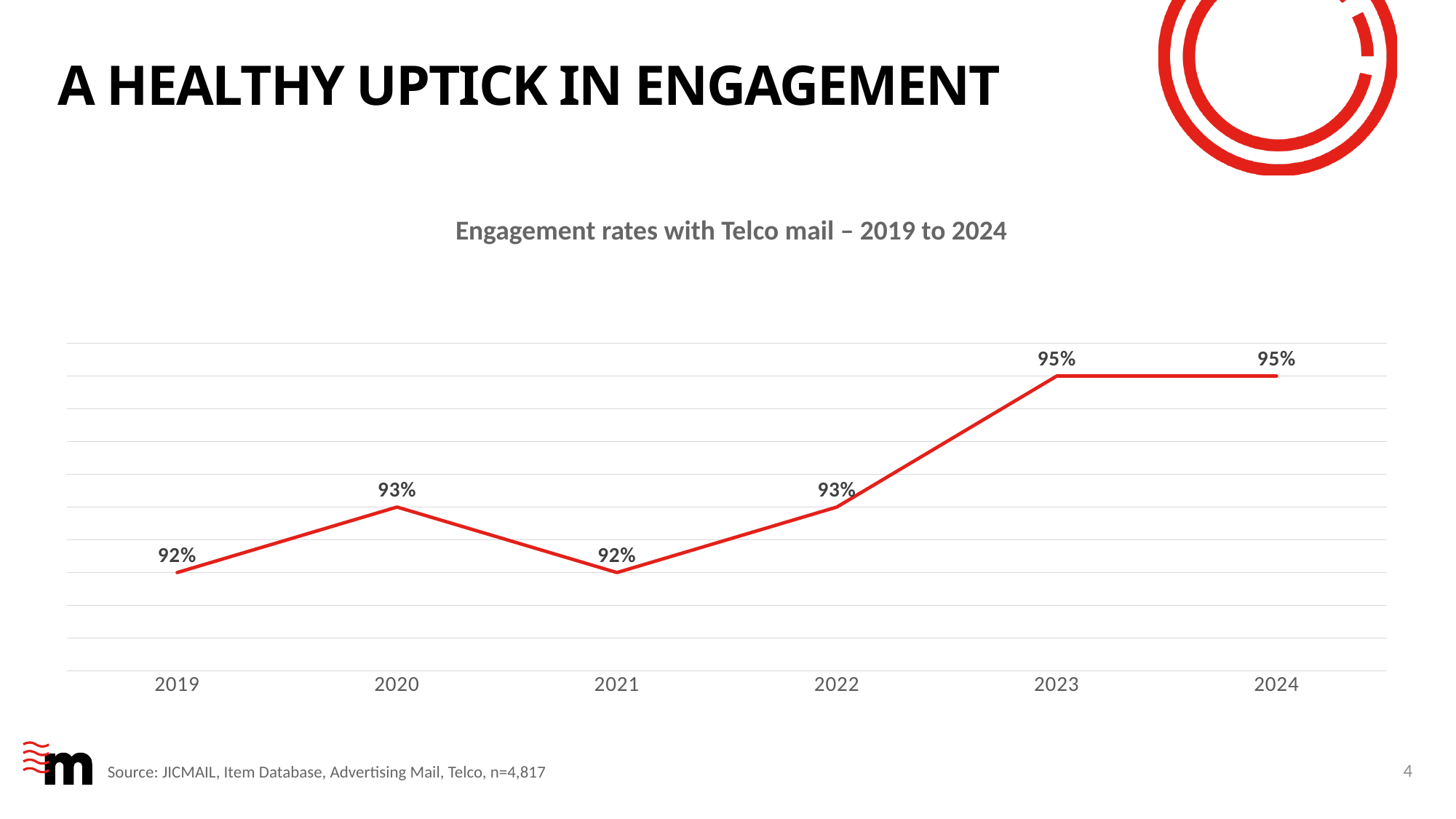
What is the lowest engagement rate shown on the chart? 92% What is the difference between the engagement rate in 2020 and the engagement rate in 2021? 1% What is the highest engagement rate shown on the chart? 95% How many years are plotted on the chart? 6 What is the engagement rate with Telco mail in 2024? 95% What kind of chart is shown on the slide? Line chart What is the engagement rate with Telco mail in 2022? 93% Which year has a higher engagement rate, 2021 or 2022? 2022 What is the engagement rate with Telco mail in 2019? 92% What is the difference between the engagement rate in 2023 and the engagement rate in 2019? 3% What is the title of the chart? Engagement rates with Telco mail – 2019 to 2024 What is the engagement rate with Telco mail in 2020? 93%